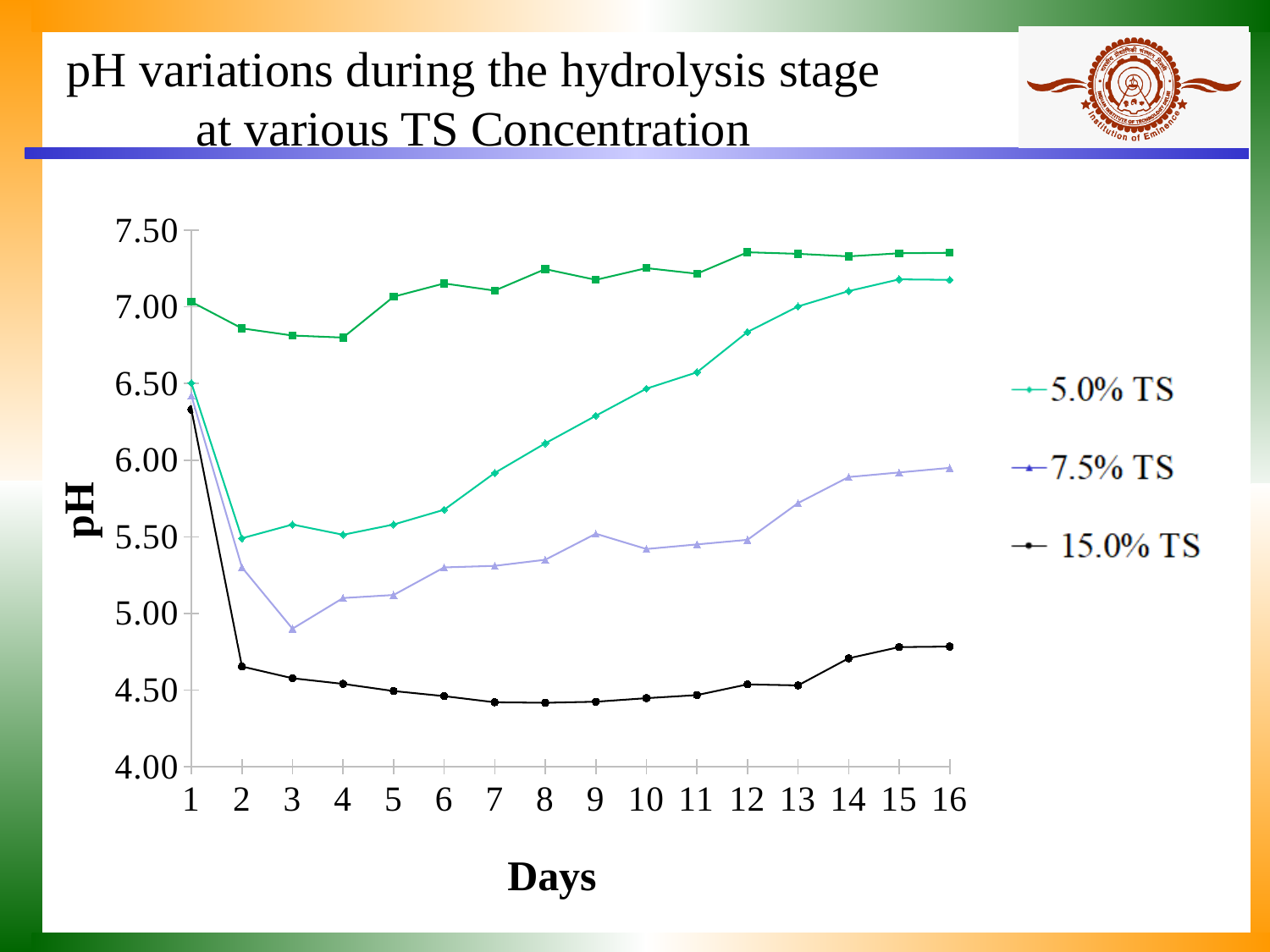
Is the pH value for 5.0% TS on day 16 greater or less than 7.00? greater Is the pH value for 5.0% TS on day 2 greater or less than 6.00? less What is the label of the x axis? Days How many days are plotted along the x axis? 16 Is the pH value for 7.5% TS on day 6 greater or less than 5.50? less What is the label of the y axis? pH Which series has the lowest pH on day 10? 15.0% TS How many series does the legend list? 3 What kind of chart is shown on the slide? line chart Does the pH for 5.0% TS rise or fall from day 7 to day 16? rise